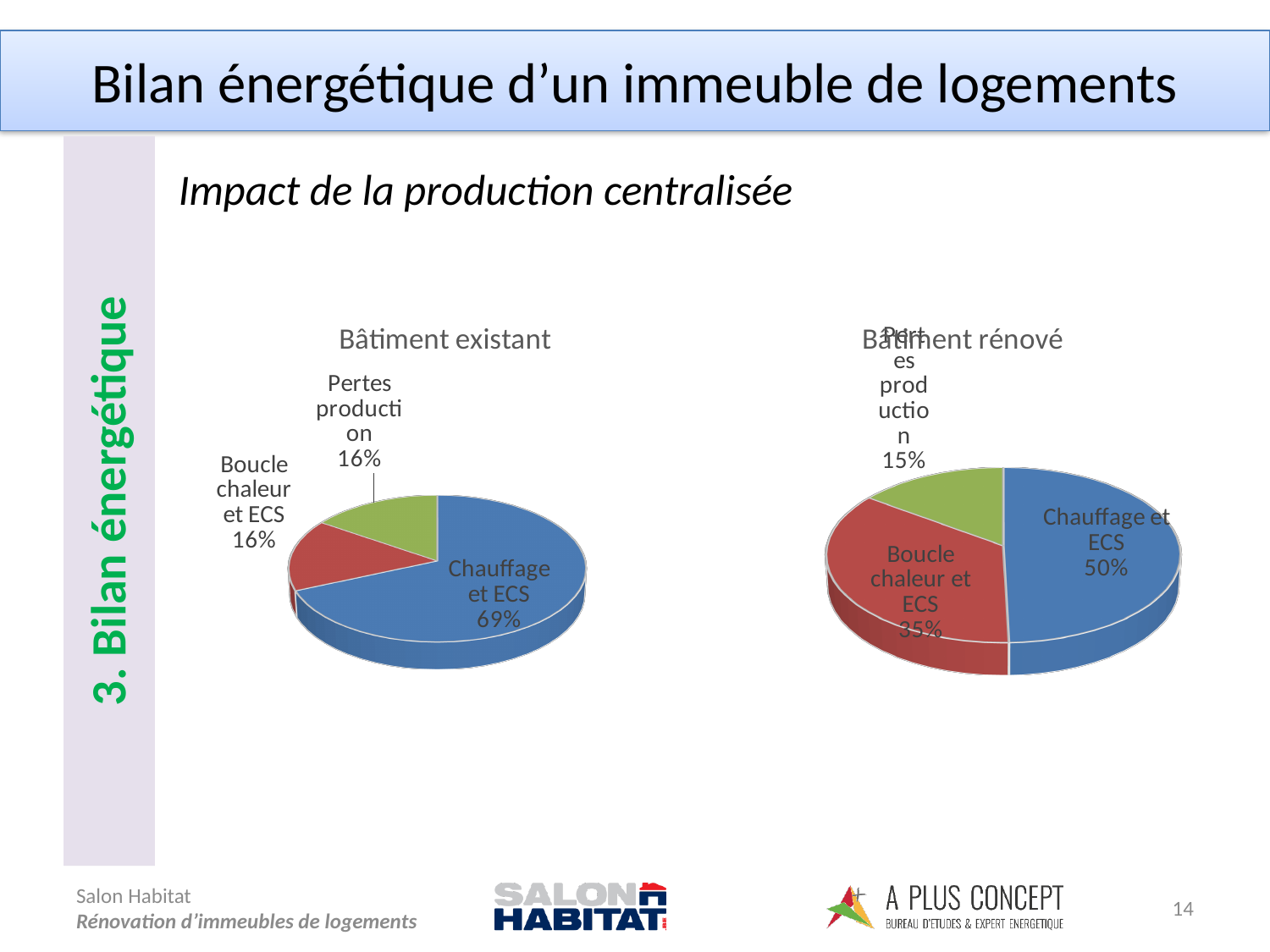
In the 'Bâtiment rénové' chart, what share does 'Boucle chaleur et ECS' represent? 35% In the 'Bâtiment existant' chart, which category has the largest share? Chauffage et ECS What type of chart is the 'Bâtiment rénové' chart? Pie chart Which is larger: 'Boucle chaleur et ECS' in the 'Bâtiment existant' chart or 'Boucle chaleur et ECS' in the 'Bâtiment rénové' chart? Bâtiment rénové In the 'Bâtiment existant' chart, what share does 'Boucle chaleur et ECS' represent? 16% In the 'Bâtiment existant' chart, what share does 'Pertes production' represent? 16% In the 'Bâtiment rénové' chart, what is the difference between the shares of 'Chauffage et ECS' and 'Boucle chaleur et ECS'? 15 percentage points In the 'Bâtiment rénové' chart, which category has the smallest share? Pertes production How many categories does the 'Bâtiment existant' chart show? 3